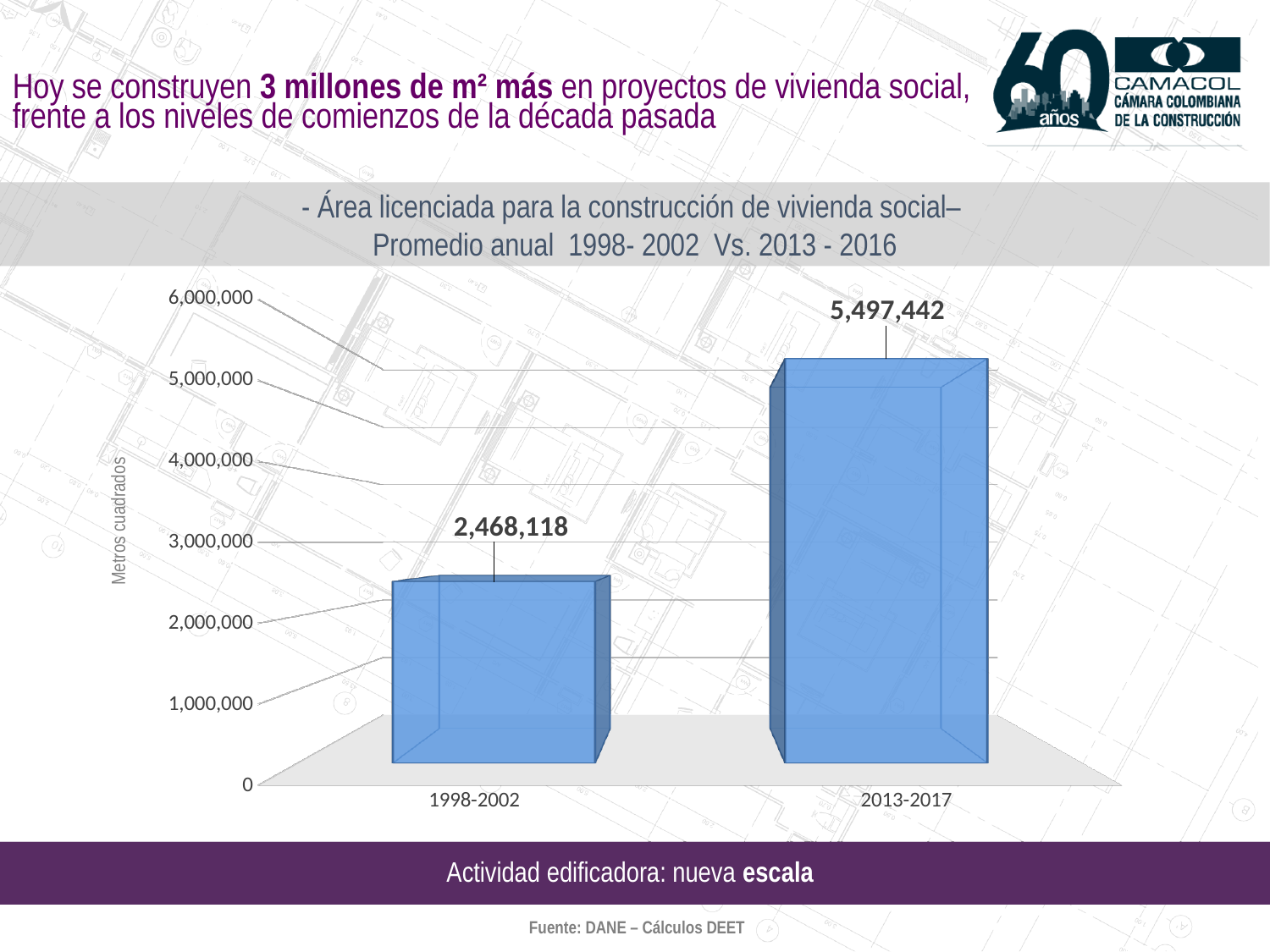
Which is larger, the value for 1998-2002 or the value for 2013-2017? 2013-2017 Is the value for 1998-2002 greater or less than 3,000,000? less What is the value for 2013-2017? 5,497,442 Which category has the lowest value? 1998-2002 What is the value for 1998-2002? 2,468,118 What is the difference between the values for 2013-2017 and 1998-2002? 3,029,324 What is the label of the vertical axis? Metros cuadrados How many categories are shown on the x axis? 2 Which category has the highest value? 2013-2017 Do the values rise or fall from 1998-2002 to 2013-2017? rise What kind of chart is shown on the slide? bar chart Is the value for 2013-2017 greater or less than 5,000,000? greater